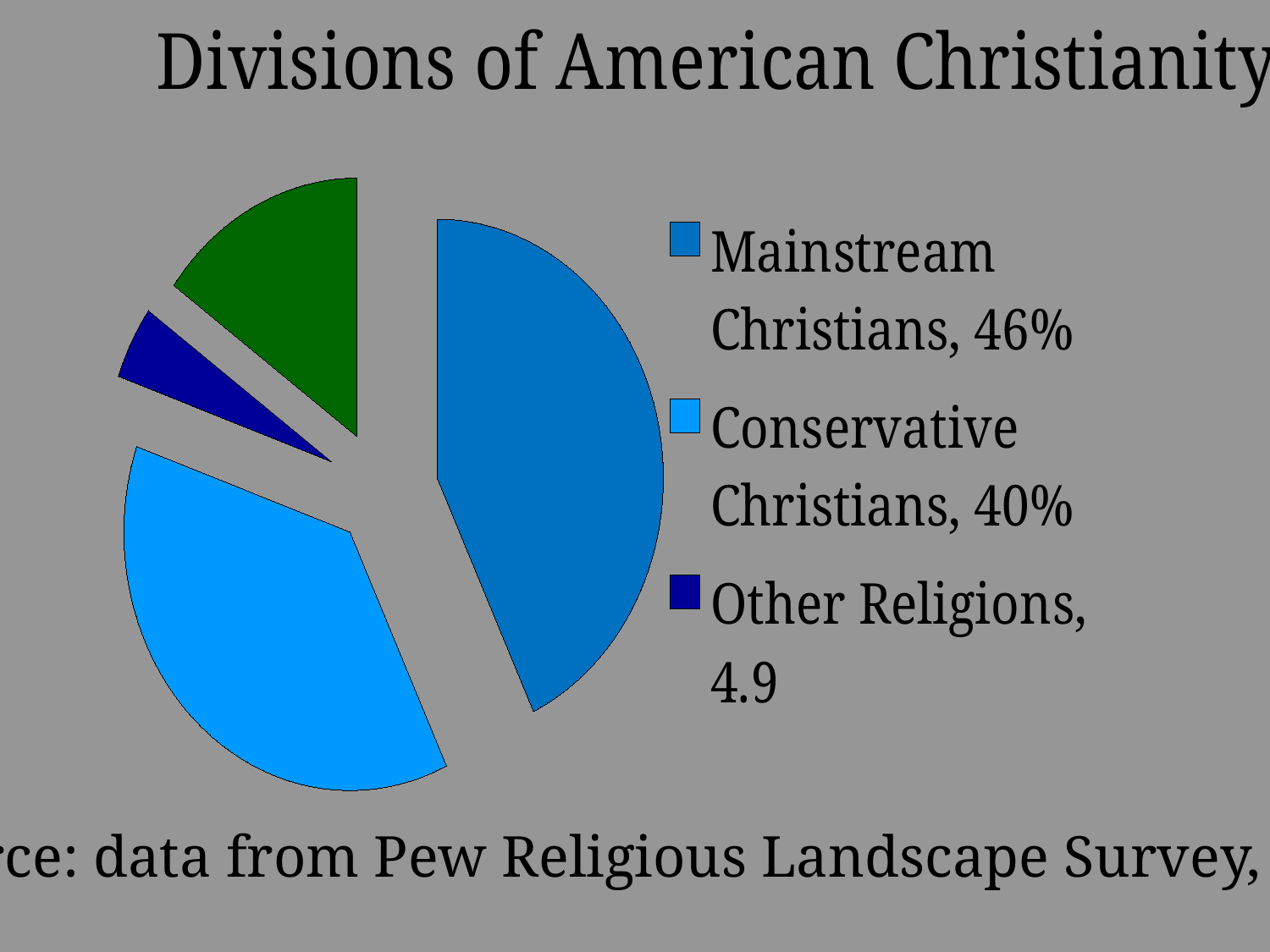
What kind of chart is shown on the slide? pie chart Which of the legend categories has the smallest slice of the pie? Other Religions What share of the pie is labelled for Mainstream Christians? 46% Which category has the largest slice of the pie? Mainstream Christians What value is shown in the legend for Other Religions? 4.9 How many entries does the legend list? 3 By how many percentage points does Mainstream Christians exceed Conservative Christians? 6 percentage points What share of the pie is labelled for Conservative Christians? 40% What colour is the slice for Conservative Christians? light blue Which is larger, the slice for Mainstream Christians or the slice for Conservative Christians? Mainstream Christians How many slices does the pie chart have? 4 What is the title of the chart? Divisions of American Christianity